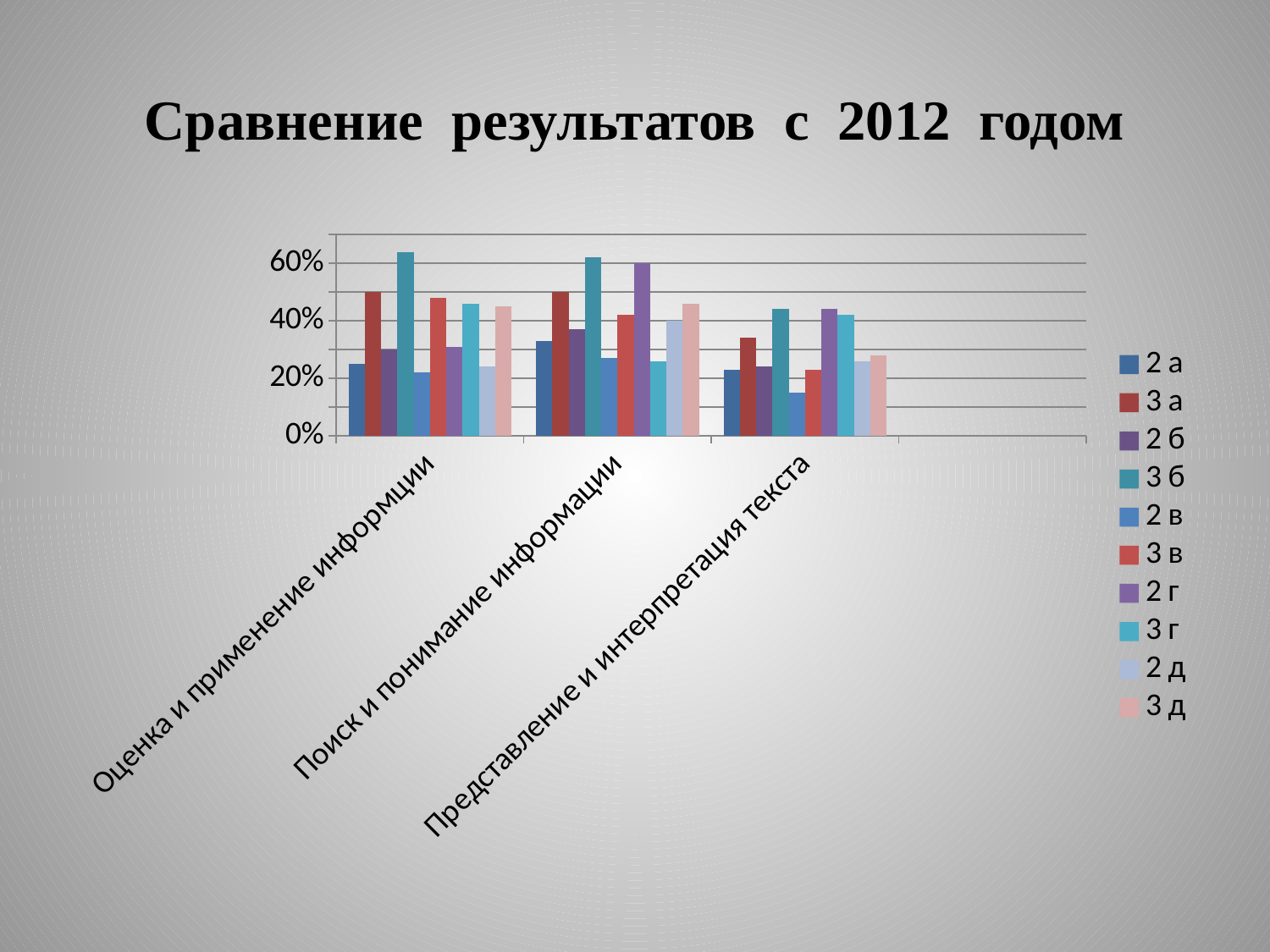
Is the value for 3 б in the category "Оценка и применение информации" greater or less than 60%? greater How many series does the chart's legend list? 10 How many categories are shown on the x axis of the chart? 3 Is the value for 3 г in the category "Поиск и понимание информации" greater or less than 40%? less Which series has the lowest value in the category "Представление и интерпретация текста"? 2 в Is the value for 2 г in the category "Поиск и понимание информации" greater or less than 40%? greater What kind of chart is shown on the slide? bar chart What is the title of the slide above the chart? Сравнение результатов с 2012 годом Which series is listed last in the chart's legend? 3 д Which series has the highest value in the category "Оценка и применение информации"? 3 б In the category "Оценка и применение информации", which is larger: the value for 3 а or the value for 2 а? 3 а